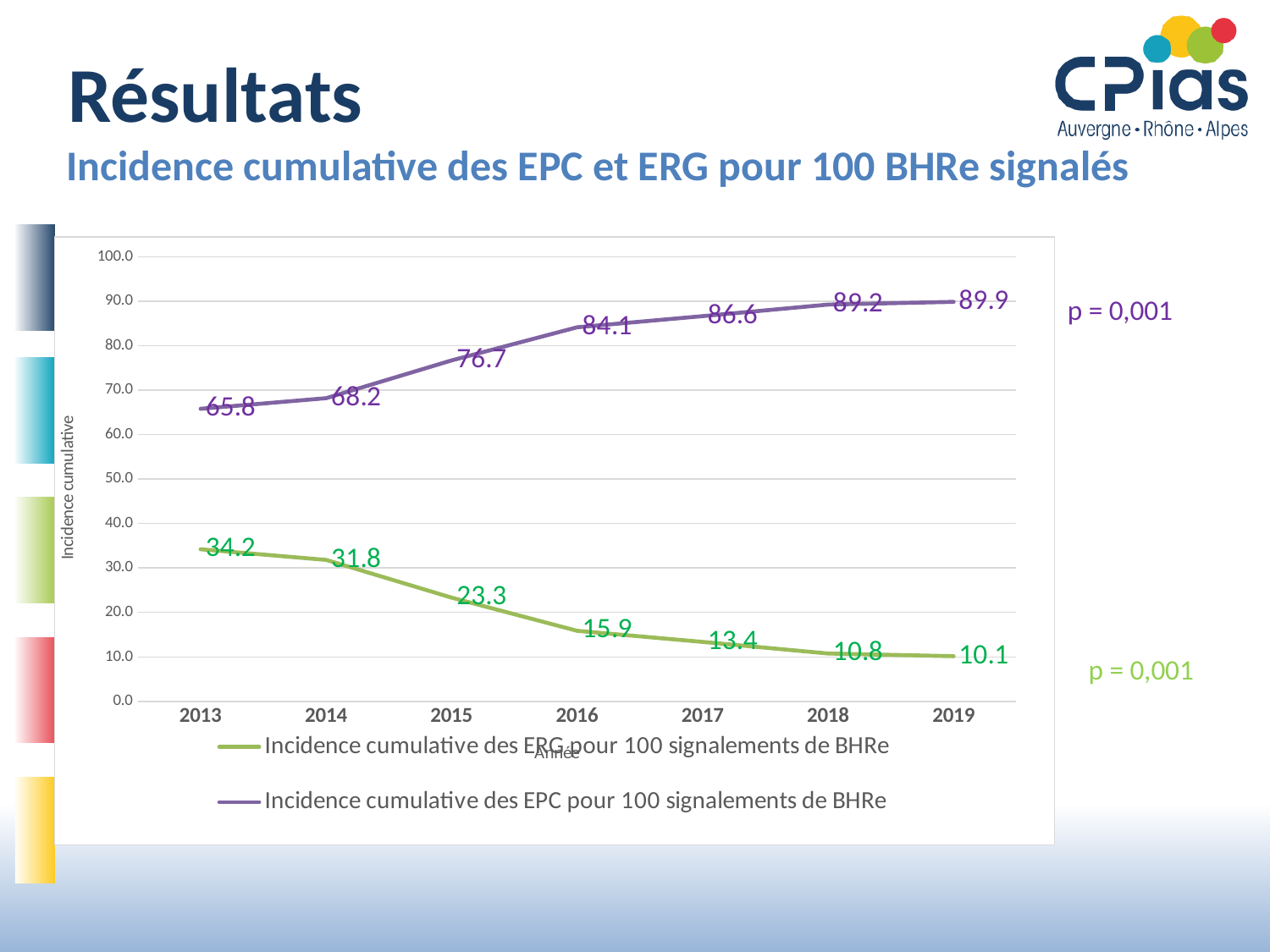
Does the ERG series rise or fall from 2013 to 2019? Fall How many series does the legend list? 2 Which series has the larger value in 2017, EPC or ERG? EPC By how much did the ERG series decrease from 2013 to 2019? 24.1 How many years are shown on the x axis? 7 What kind of chart is shown on the slide? Line chart What is the value of the ERG series (Incidence cumulative des ERG pour 100 signalements de BHRe) in 2015? 23.3 What is the difference between the EPC value and the ERG value in 2013? 31.6 In which year is the EPC series at its highest? 2019 What is the value of the EPC series (Incidence cumulative des EPC pour 100 signalements de BHRe) in 2016? 84.1 In which year is the ERG series at its lowest? 2019 What is the label of the y axis? Incidence cumulative